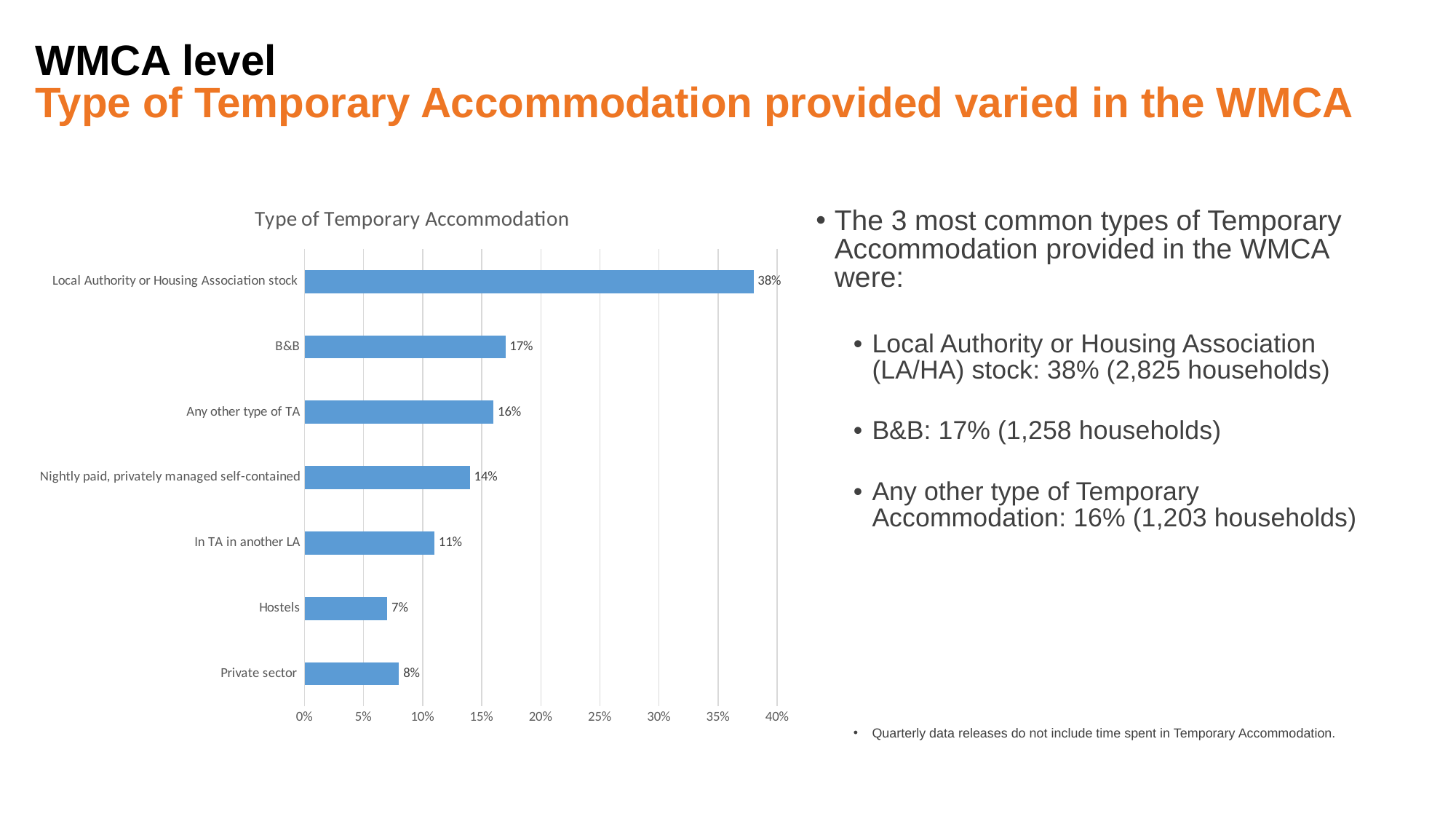
Which category has the lowest value? Hostels How many categories are shown in the chart? 7 Which is larger, the value for In TA in another LA or the value for Private sector? In TA in another LA What is the value for B&B? 17% What is the value for Hostels? 7% Which category has the highest value? Local Authority or Housing Association stock Is the value for Any other type of TA greater or less than 20%? less What is the value for Nightly paid, privately managed self-contained? 14% What is the title of the chart? Type of Temporary Accommodation What is the value for Local Authority or Housing Association stock? 38% What kind of chart is shown on the slide? bar chart What is the difference between the values for Local Authority or Housing Association stock and B&B? 21%